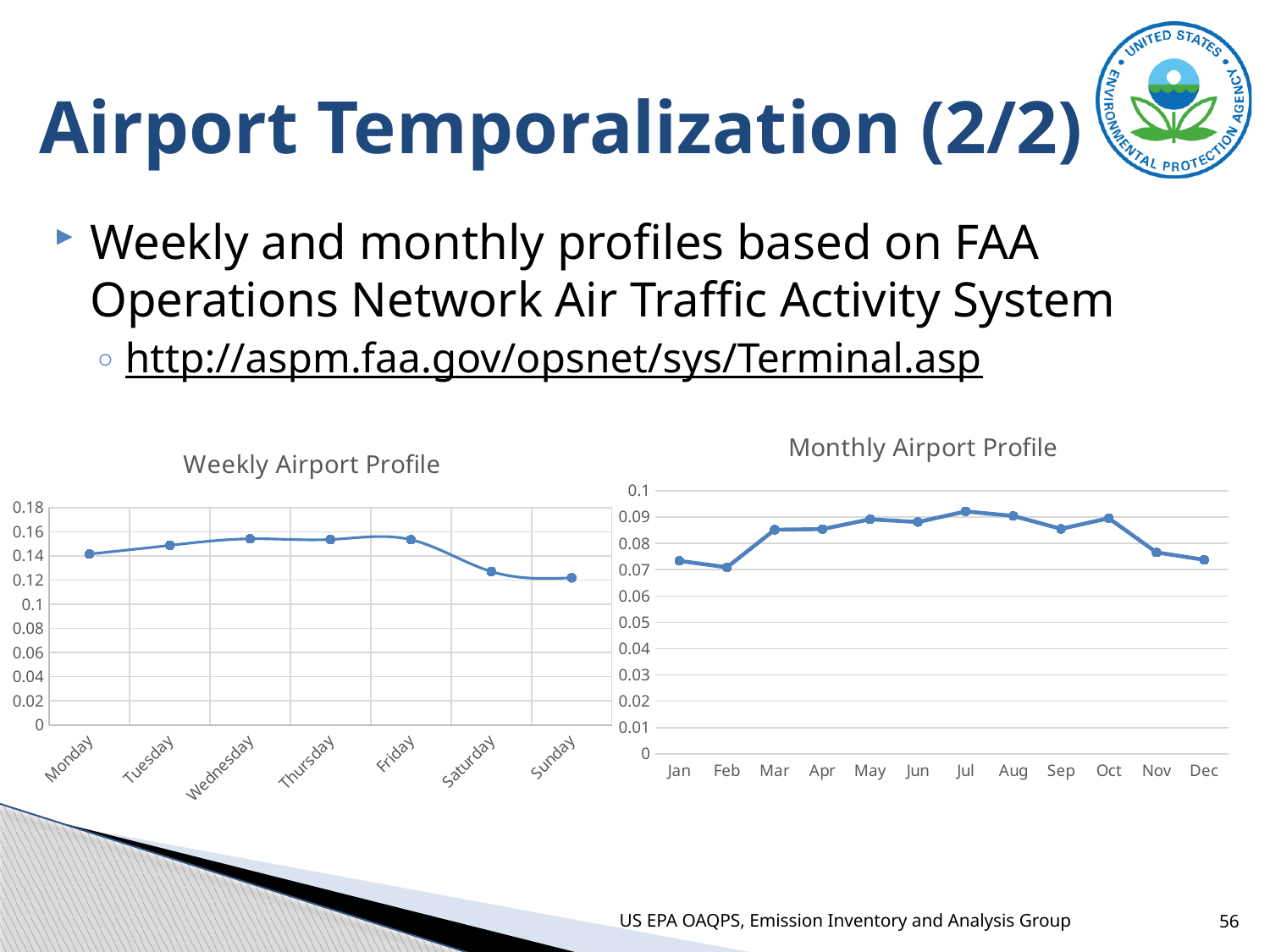
In the Monthly Airport Profile chart, is the value for Jul greater or less than 0.08? greater In the Weekly Airport Profile chart, is the value for Sunday greater or less than 0.14? less In the Monthly Airport Profile chart, which is larger, the value for Mar or the value for Feb? Mar In the Weekly Airport Profile chart, which is larger, the value for Monday or the value for Sunday? Monday What kind of chart is the Weekly Airport Profile? line chart What is the title of the chart on the right side of the slide? Monthly Airport Profile In the Weekly Airport Profile chart, do the values rise or fall from Friday to Sunday? fall In the Weekly Airport Profile chart, is the value for Monday greater or less than 0.12? greater How many months are plotted in the Monthly Airport Profile chart? 12 How many categories are plotted on the x axis of the Weekly Airport Profile chart? 7 In the Monthly Airport Profile chart, do the values rise or fall from Oct to Dec? fall